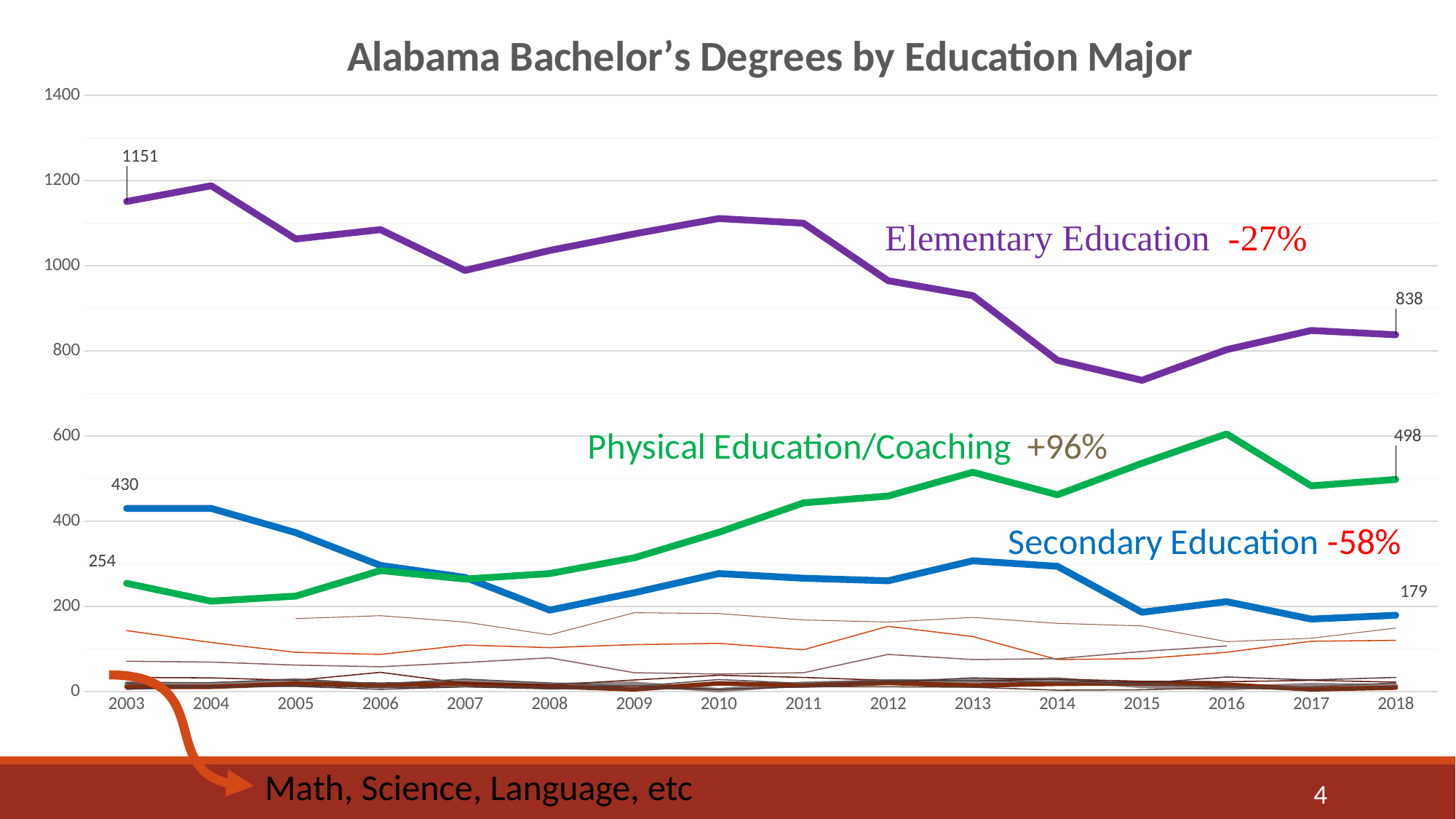
What is the difference between the Secondary Education values in 2003 and 2018? 251 What is the difference between the Elementary Education values in 2003 and 2018? 313 What kind of chart is shown on the slide? line chart What is the value for Secondary Education in 2003? 430 How many years are shown on the x axis? 16 What is the value for Physical Education/Coaching in 2018? 498 What is the title of the chart? Alabama Bachelor's Degrees by Education Major Is the value for Elementary Education in 2015 greater or less than 800? less Does the Secondary Education line rise or fall from 2003 to 2018? fall What is the value for Elementary Education in 2003? 1151 Which series has the highest value in 2018: Elementary Education, Physical Education/Coaching, or Secondary Education? Elementary Education What is the value for Elementary Education in 2018? 838